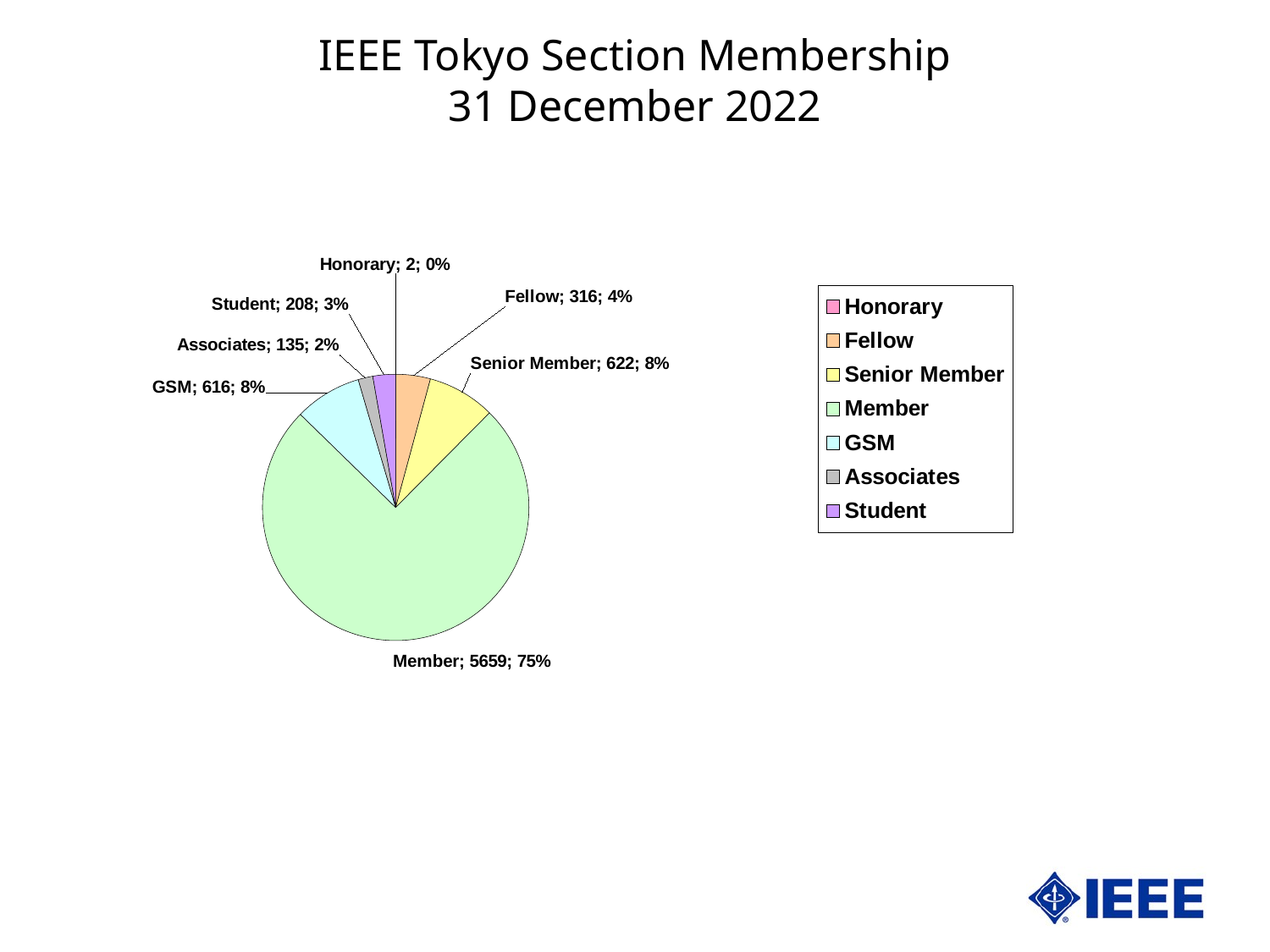
How many members are in the Member category? 5659 Which category has the largest slice of the pie? Member How many GSM members are shown? 616 What type of chart is shown on the slide? Pie chart What is the title of the chart on the slide? IEEE Tokyo Section Membership 31 December 2022 How many categories does the pie chart show? 7 Which is larger, the Fellow count or the Student count? Fellow What share of the pie does the Senior Member slice represent? 8% What is the difference between the Senior Member count and the GSM count? 6 Which category has the smallest slice of the pie? Honorary What percentage of the membership is Student? 3% What is the number of Fellows shown on the pie chart? 316